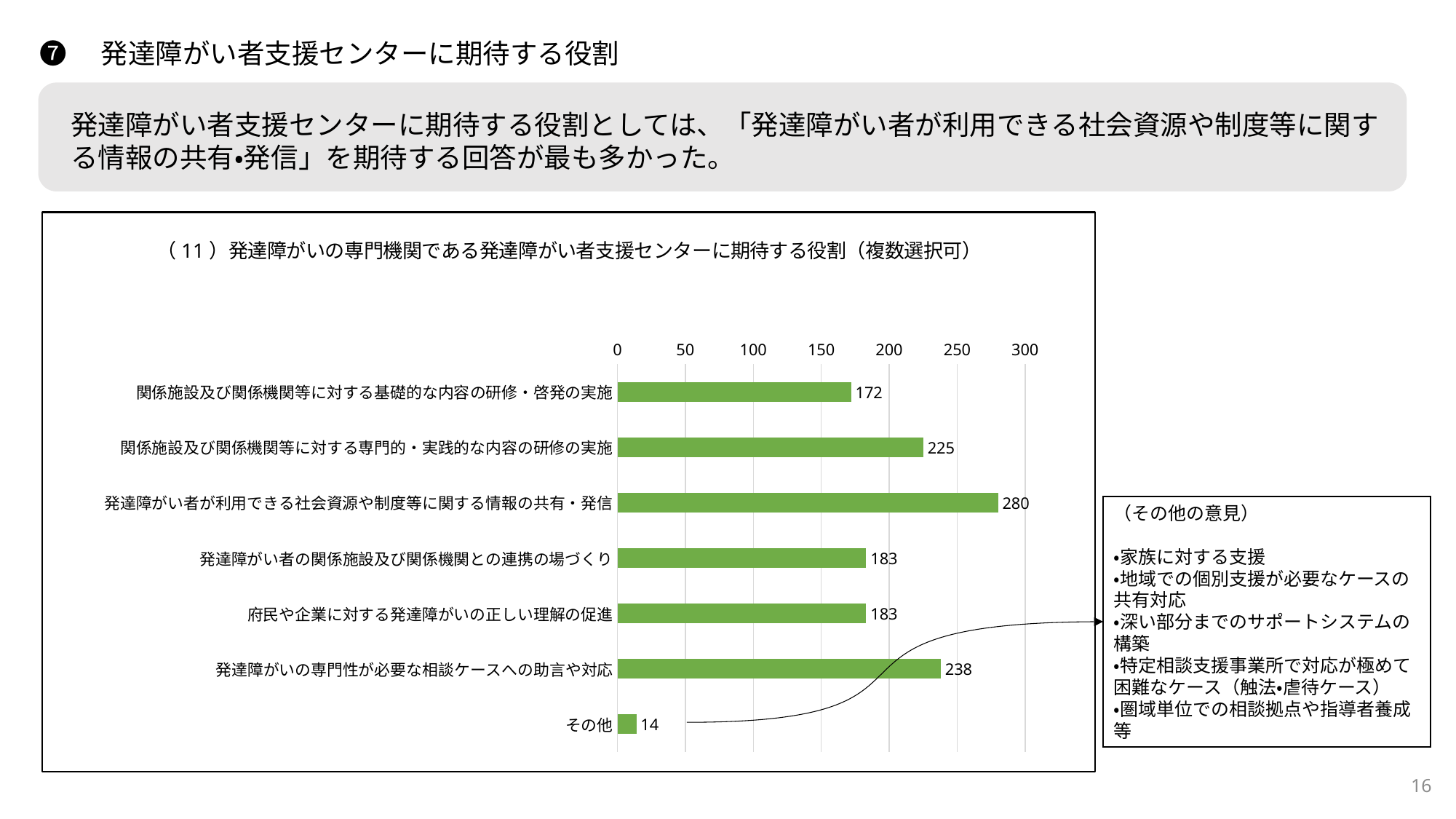
What kind of chart is shown on the slide? Bar chart What is the difference between the values for 関係施設及び関係機関等に対する専門的・実践的な内容の研修の実施 and 関係施設及び関係機関等に対する基礎的な内容の研修・啓発の実施? 53 How many categories are shown in the chart? 7 What is the difference between the values for 発達障がい者が利用できる社会資源や制度等に関する情報の共有・発信 and 発達障がいの専門性が必要な相談ケースへの助言や対応? 42 What is the value for 関係施設及び関係機関等に対する専門的・実践的な内容の研修の実施? 225 What is the value for 発達障がいの専門性が必要な相談ケースへの助言や対応? 238 What is the value for その他? 14 What is the value for 発達障がい者が利用できる社会資源や制度等に関する情報の共有・発信? 280 Which category has the lowest value? その他 Which category has the highest value? 発達障がい者が利用できる社会資源や制度等に関する情報の共有・発信 What is the title of the chart? （11）発達障がいの専門機関である発達障がい者支援センターに期待する役割（複数選択可） Which is larger, the value for 関係施設及び関係機関等に対する基礎的な内容の研修・啓発の実施 or the value for 発達障がい者の関係施設及び関係機関との連携の場づくり? 発達障がい者の関係施設及び関係機関との連携の場づくり